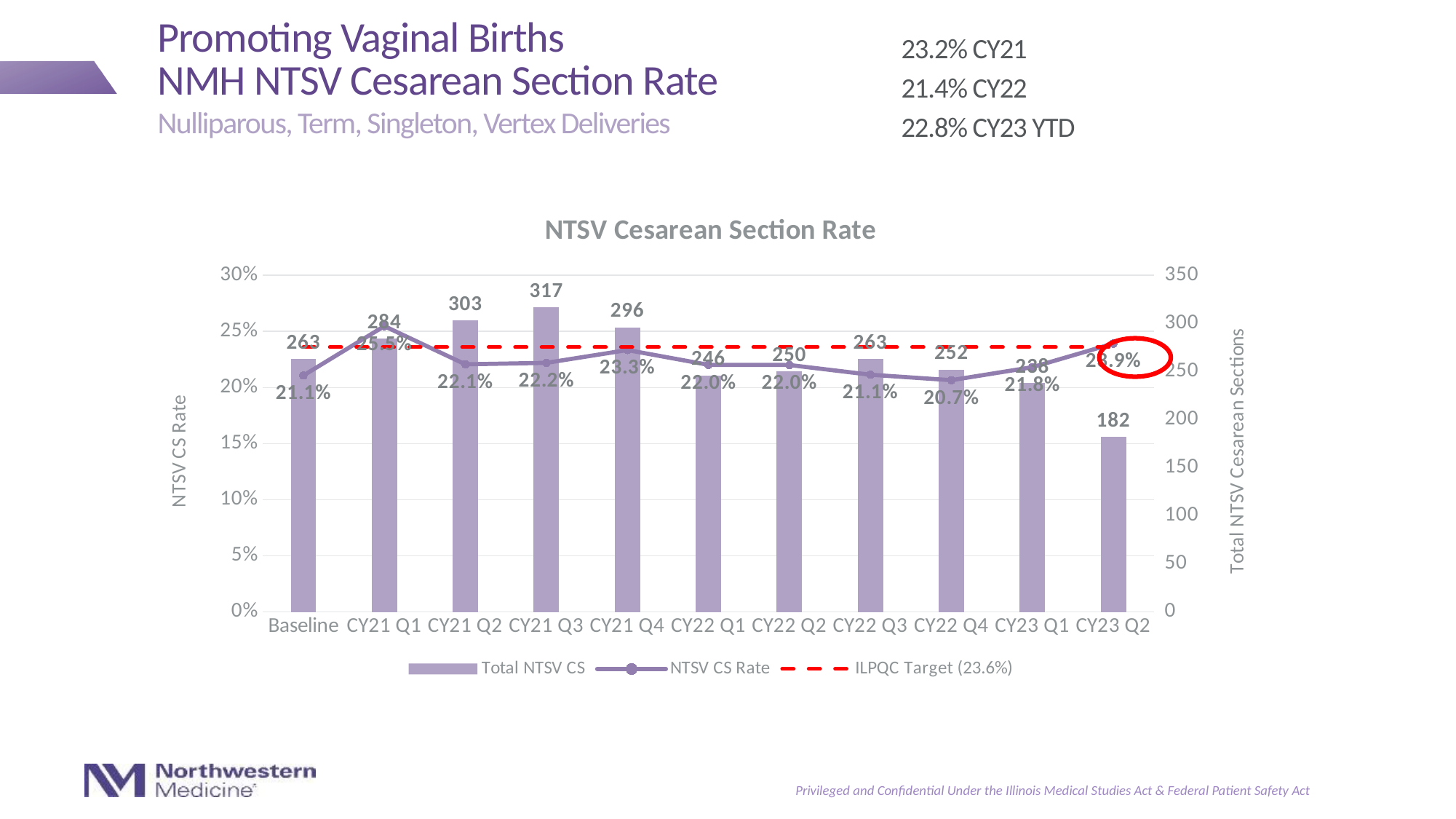
What is the Total NTSV CS value for CY21 Q3? 317 What is the Total NTSV CS value for CY23 Q2? 182 Which period has the highest NTSV CS Rate? CY21 Q1 What is the difference between the Total NTSV CS values for CY21 Q3 and CY23 Q2? 135 What is the NTSV CS Rate for CY22 Q4? 20.7% Which period has the lowest NTSV CS Rate? CY22 Q4 What is the NTSV CS Rate for CY21 Q4? 23.3% Which period has the highest Total NTSV CS bar? CY21 Q3 How many periods are shown on the x axis of the chart? 11 Which has a larger Total NTSV CS value, CY21 Q2 or CY21 Q4? CY21 Q2 What is the target value shown in the legend for the ILPQC Target line? 23.6% How many series does the chart legend list? 3